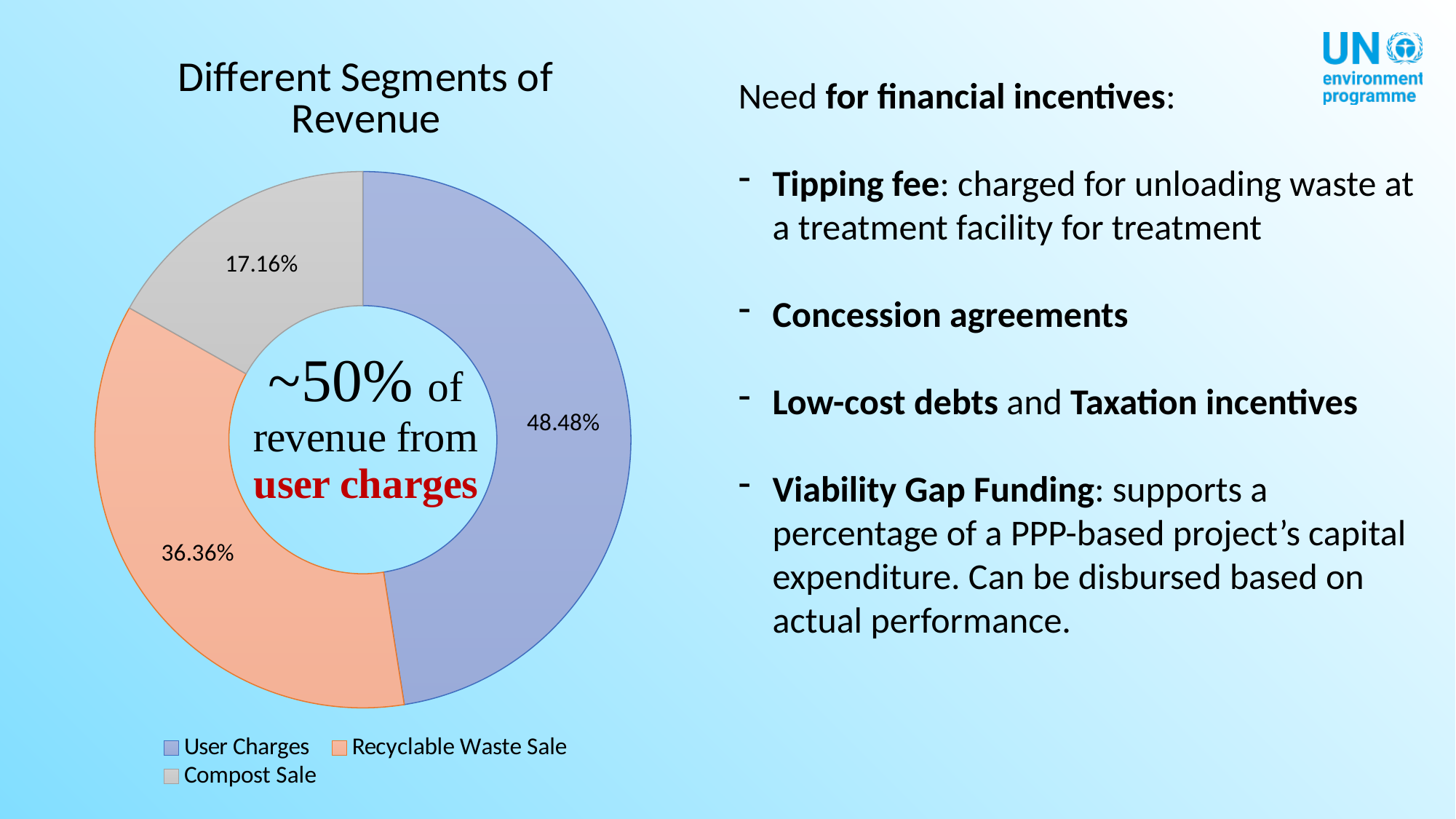
What is the title of the chart? Different Segments of Revenue What percentage of revenue comes from User Charges? 48.48% What percentage of revenue comes from Recyclable Waste Sale? 36.36% What kind of chart is shown on the slide? Doughnut chart How many revenue segments does the chart show? 3 Which is larger, the share for Recyclable Waste Sale or the share for Compost Sale? Recyclable Waste Sale What is the difference in percentage points between User Charges and Recyclable Waste Sale? 12.12 What is the difference in percentage points between Recyclable Waste Sale and Compost Sale? 19.2 What percentage of revenue comes from Compost Sale? 17.16% Which revenue segment has the smallest share? Compost Sale What text is shown in the centre of the doughnut chart? ~50% of revenue from user charges Which revenue segment has the largest share? User Charges